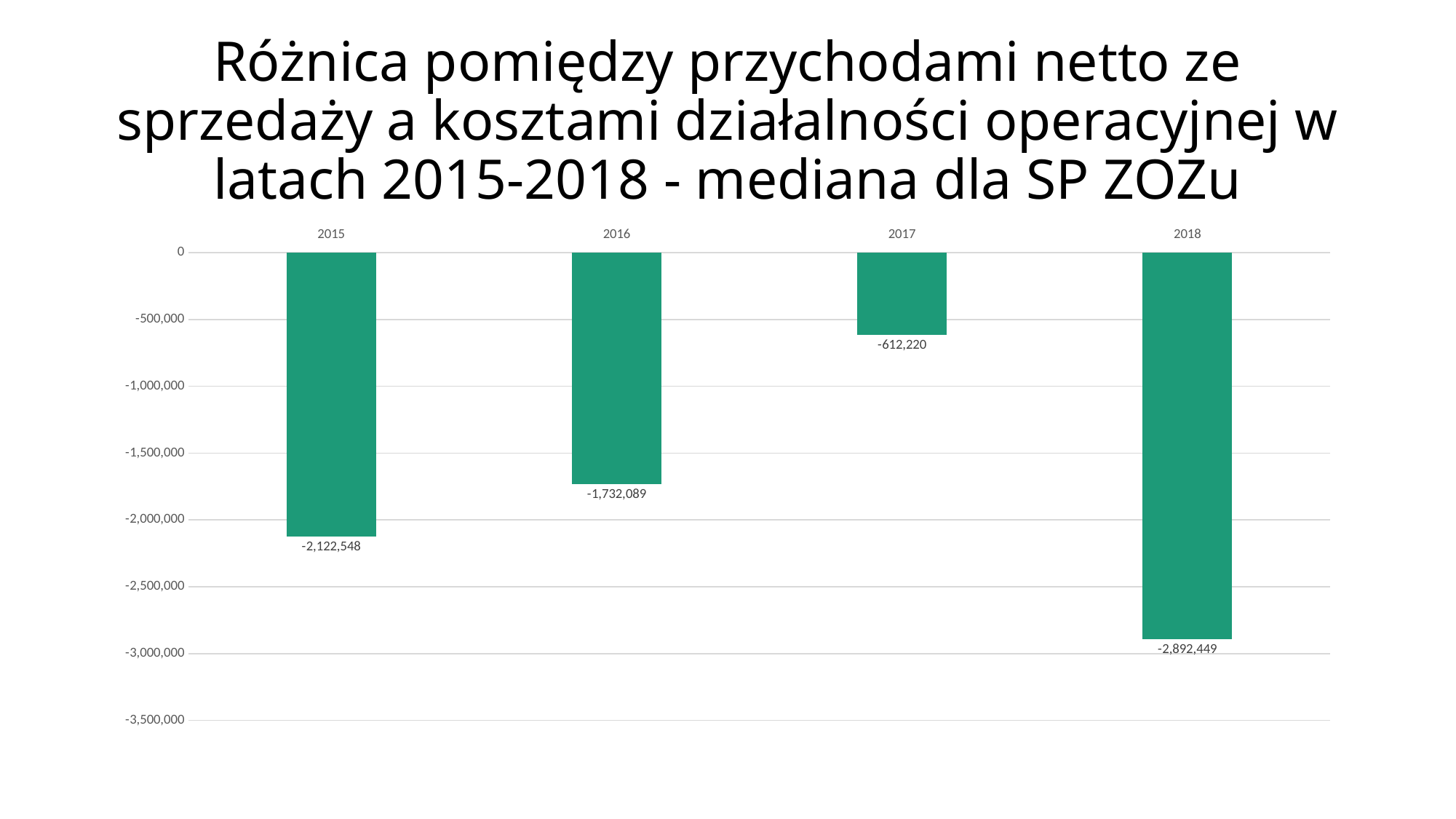
Which year has the lowest (most negative) value? 2018 How many years are shown on the chart? 4 What kind of chart is shown on the slide? bar chart Which year has the highest (least negative) value? 2017 What is the value for 2018? -2,892,449 What is the difference between the values for 2018 and 2015? 769,901 Which year has the larger (less negative) value, 2015 or 2016? 2016 What is the difference between the values for 2016 and 2017? 1,119,869 What is the value for 2015? -2,122,548 What is the value for 2016? -1,732,089 Is the value for 2017 greater or less than -500,000? less What is the value for 2017? -612,220